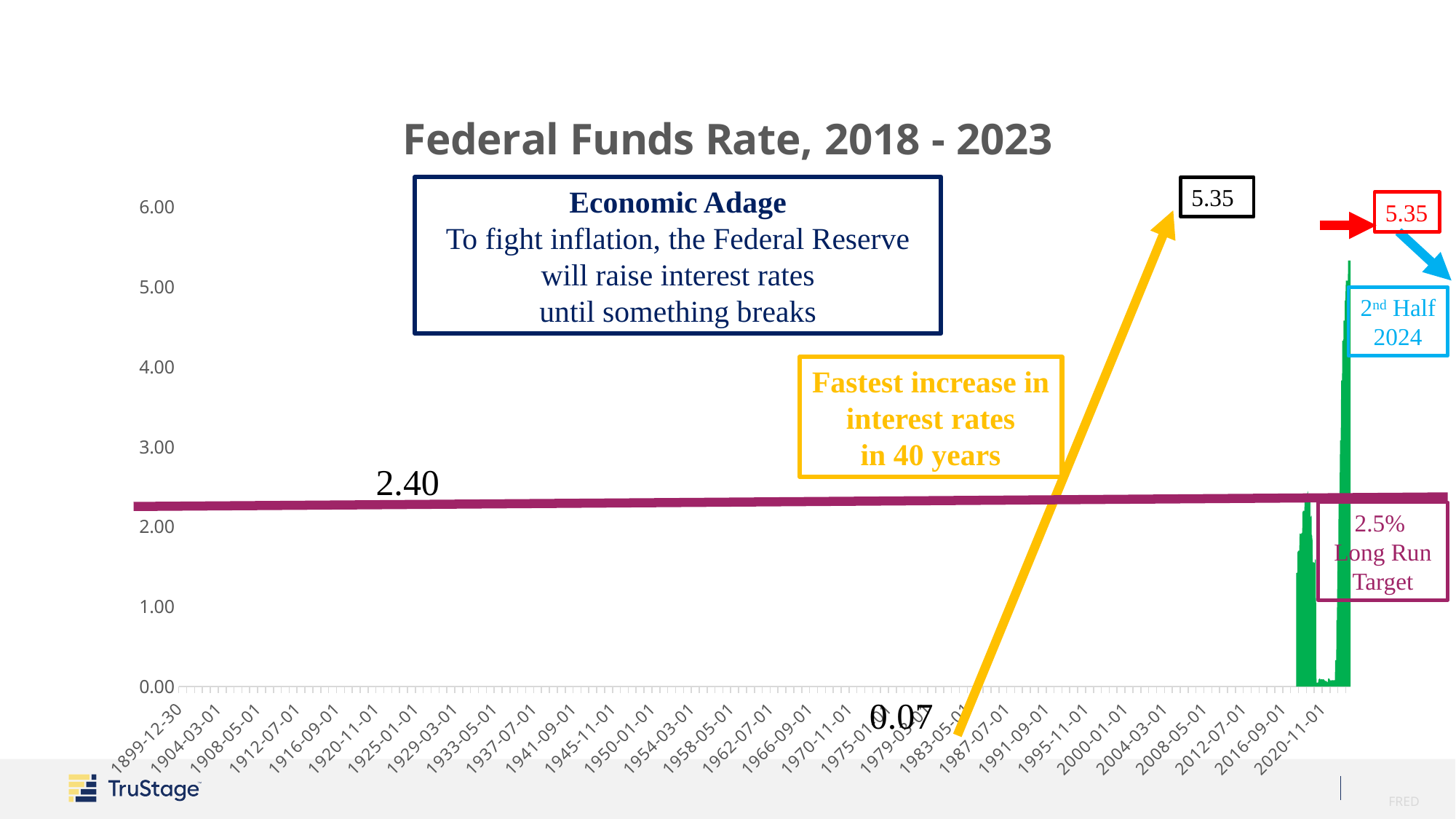
What is the peak value of the Federal Funds Rate labelled on the chart? 5.35 What is the difference between the labelled peak rate of 5.35 and the labelled low of 0.07? 5.28 What rate is shown in the red box for the 2nd Half of 2024? 5.35 What long run target percentage is stated in the purple box on the chart? 2.5% What is the highest tick value shown on the vertical axis? 6.00 What is the lowest value of the Federal Funds Rate labelled on the chart? 0.07 Is the peak value of the Federal Funds Rate greater or less than 5.00? greater What value is labelled on the purple horizontal line across the chart? 2.40 What is the title of the chart? Federal Funds Rate, 2018 - 2023 Which is larger, the labelled peak rate or the value on the purple horizontal line? the labelled peak rate (5.35) What kind of chart is shown on the slide? line chart What is the difference between the labelled peak rate of 5.35 and the purple line value of 2.40? 2.95